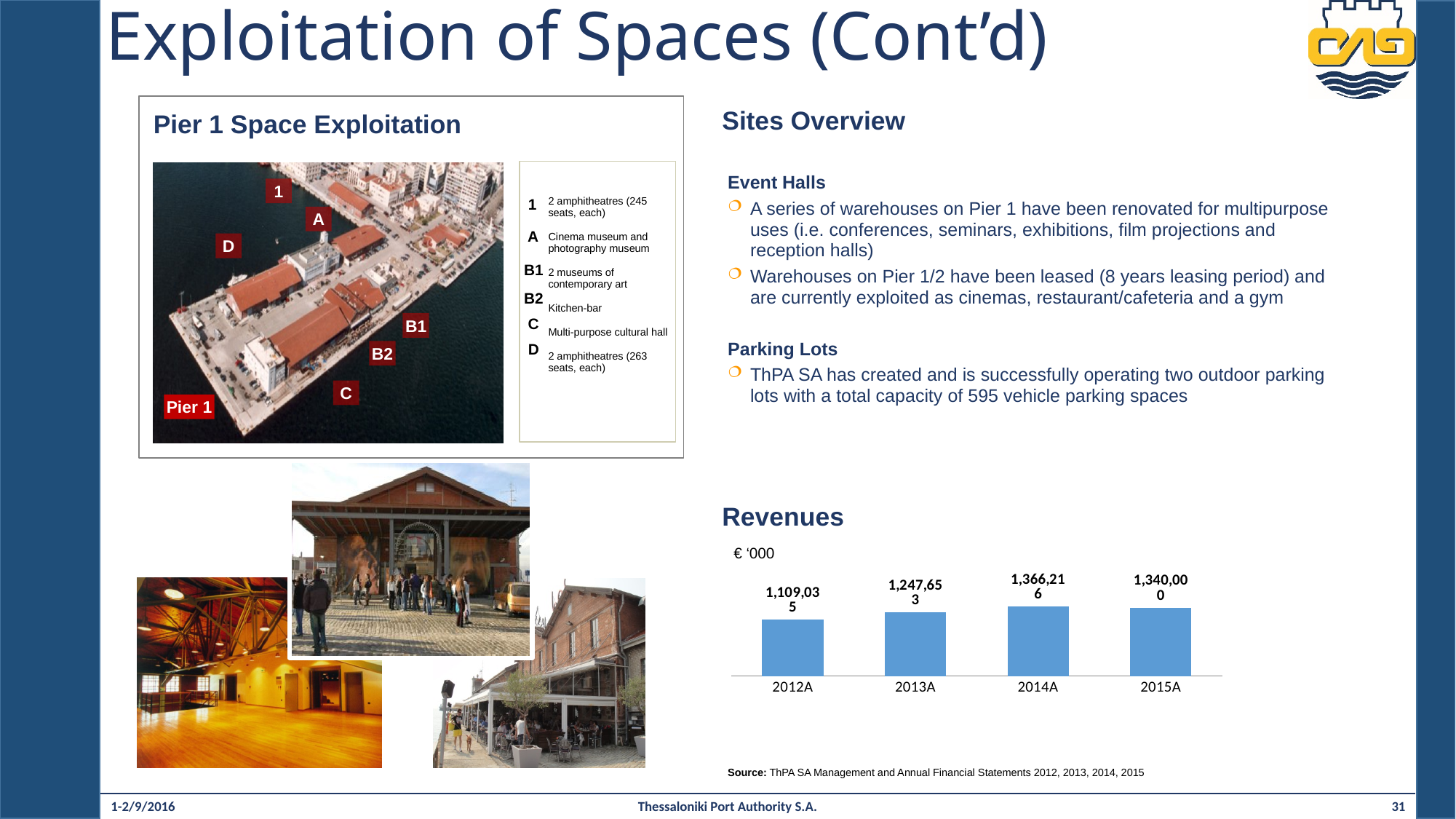
Which year has the highest revenue in the Revenues chart? 2014A In the Revenues chart, do the values rise or fall from 2012A to 2014A? Rise What unit is indicated above the Revenues chart? € '000 Which year has the lowest revenue in the Revenues chart? 2012A How many years are shown in the Revenues chart? 4 What is the revenue value shown for 2012A in the Revenues chart? 1,109,035 What type of chart is the Revenues chart? Bar chart What is the revenue value shown for 2015A in the Revenues chart? 1,340,000 In the Revenues chart, what is the difference between the 2015A and 2012A values? 230,965 What is the revenue value shown for 2014A in the Revenues chart? 1,366,216 In the Revenues chart, which is larger: the value for 2013A or the value for 2015A? 2015A In the Revenues chart, what is the difference between the 2014A and 2013A values? 118,563